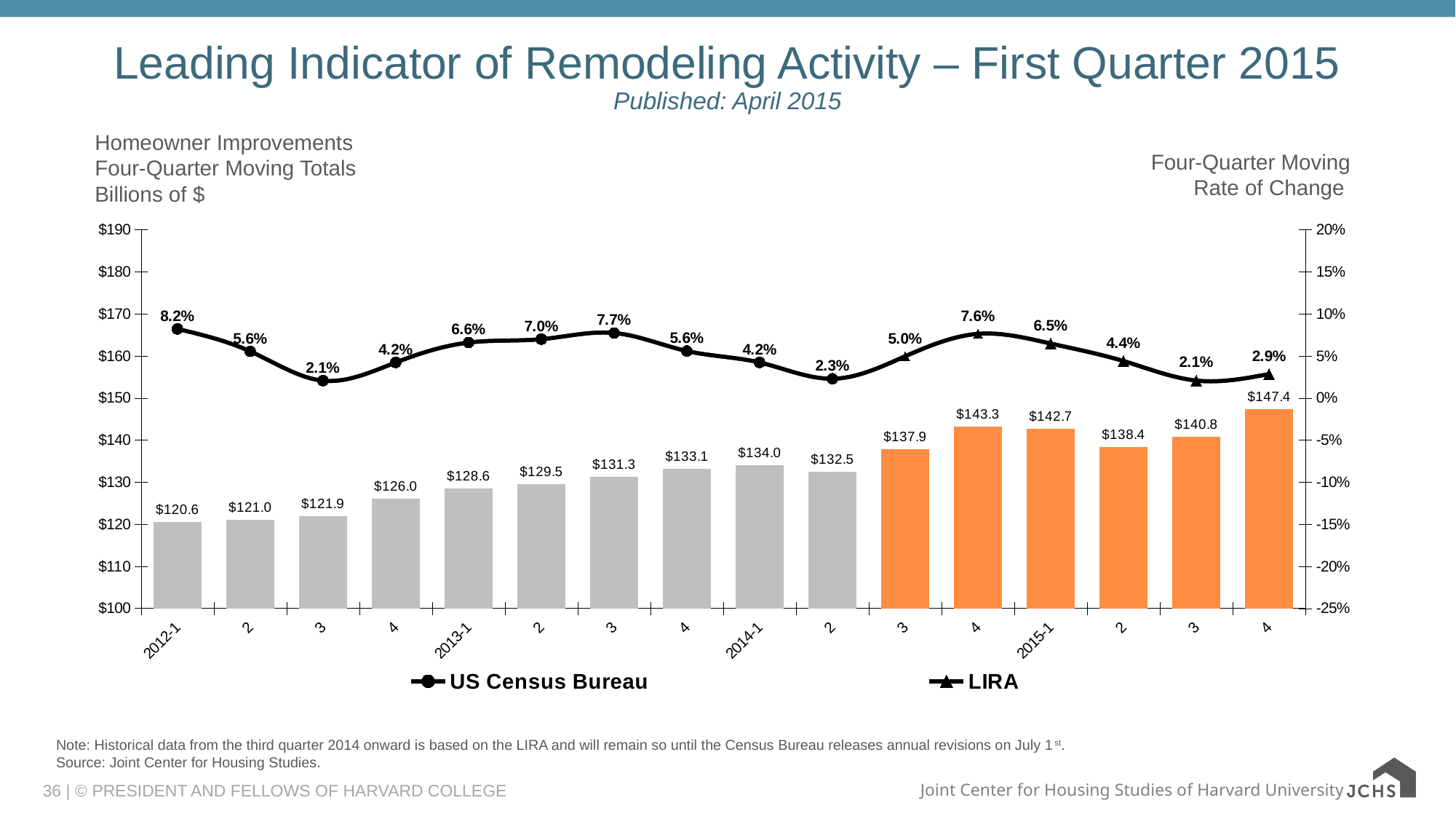
How many series does the legend list? 2 Which quarter has the highest four-quarter moving total bar? 2015-4 What is the four-quarter moving total for 2014-1? $134.0 What is the four-quarter moving rate of change shown for the last quarter plotted (2015-4)? 2.9% What is the difference between the four-quarter moving totals for 2015-4 ($147.4) and 2015-1 ($142.7)? $4.7 What is the four-quarter moving rate of change shown for the third quarter of 2013 (2013-3)? 7.7% How many quarterly bars are plotted on the chart? 16 Which is larger, the four-quarter moving total for 2014-2 or for 2014-3? 2014-3 What are the two series named in the legend? US Census Bureau and LIRA What kind of chart is shown on the slide? Combined bar and line chart Which quarter has the lowest four-quarter moving total bar? 2012-1 Is the four-quarter moving total bar for 2013-4 greater or less than $130? greater